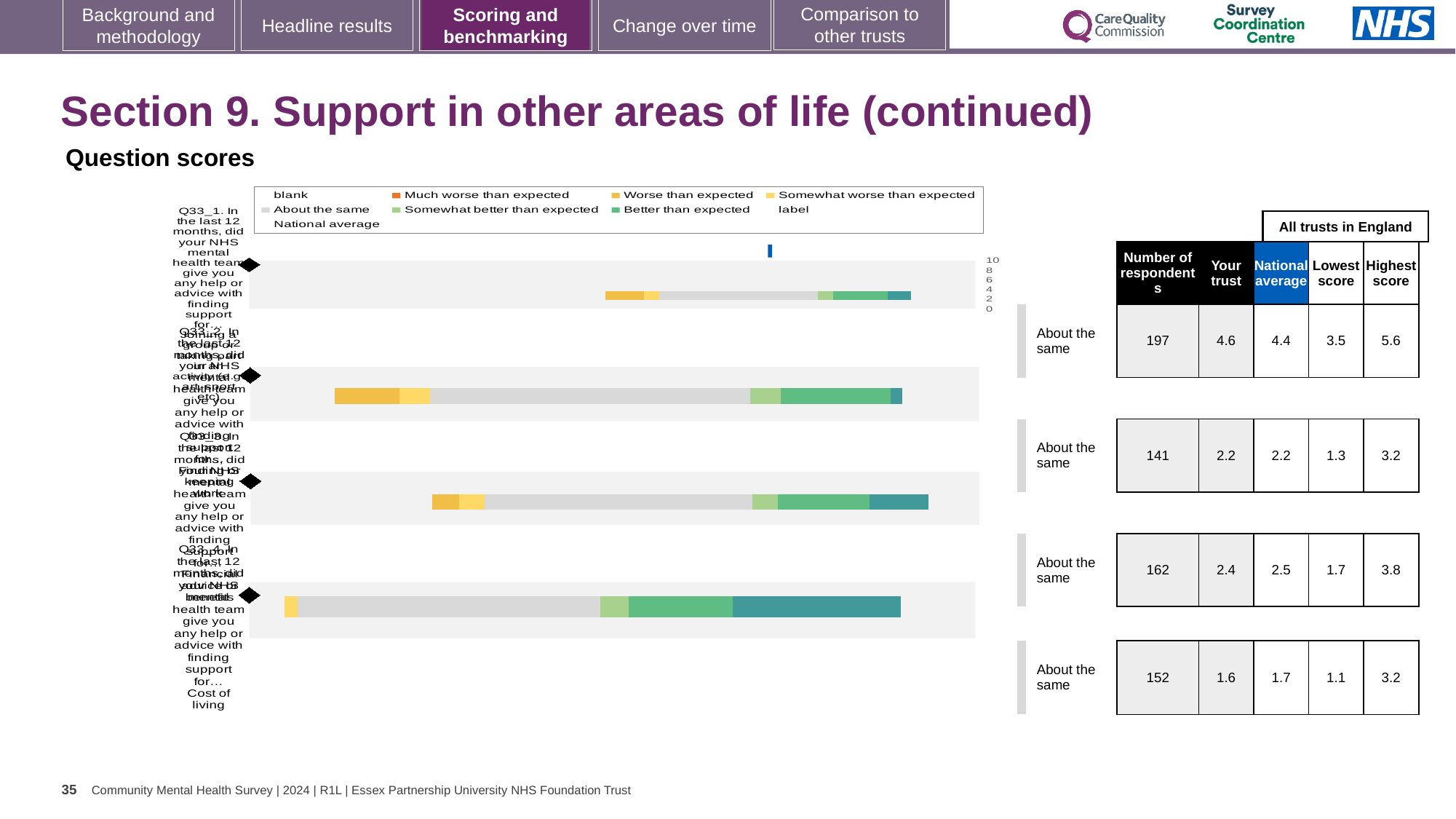
How many question bars are plotted in the question scores chart? 4 Which question row in the table has the highest 'Your trust' score? The first row (4.6) What benchmark label is shown next to each of the four question bars? About the same In the table beside the chart, how many respondents are listed for the second question? 141 In the table beside the chart, what is the 'Your trust' score for the first question (197 respondents)? 4.6 In the table beside the chart, what is the national average for the first question (197 respondents)? 4.4 In the table beside the chart, what is the lowest score for the fourth question (152 respondents)? 1.1 What is the heading shown above the question scores chart? Question scores In the table beside the chart, what is the difference between the highest score (5.6) and the lowest score (3.5) for the first question? 2.1 For the third question (162 respondents), which is larger: the 'Your trust' score or the national average? National average What type of chart is used to show the question scores on this slide? bar chart